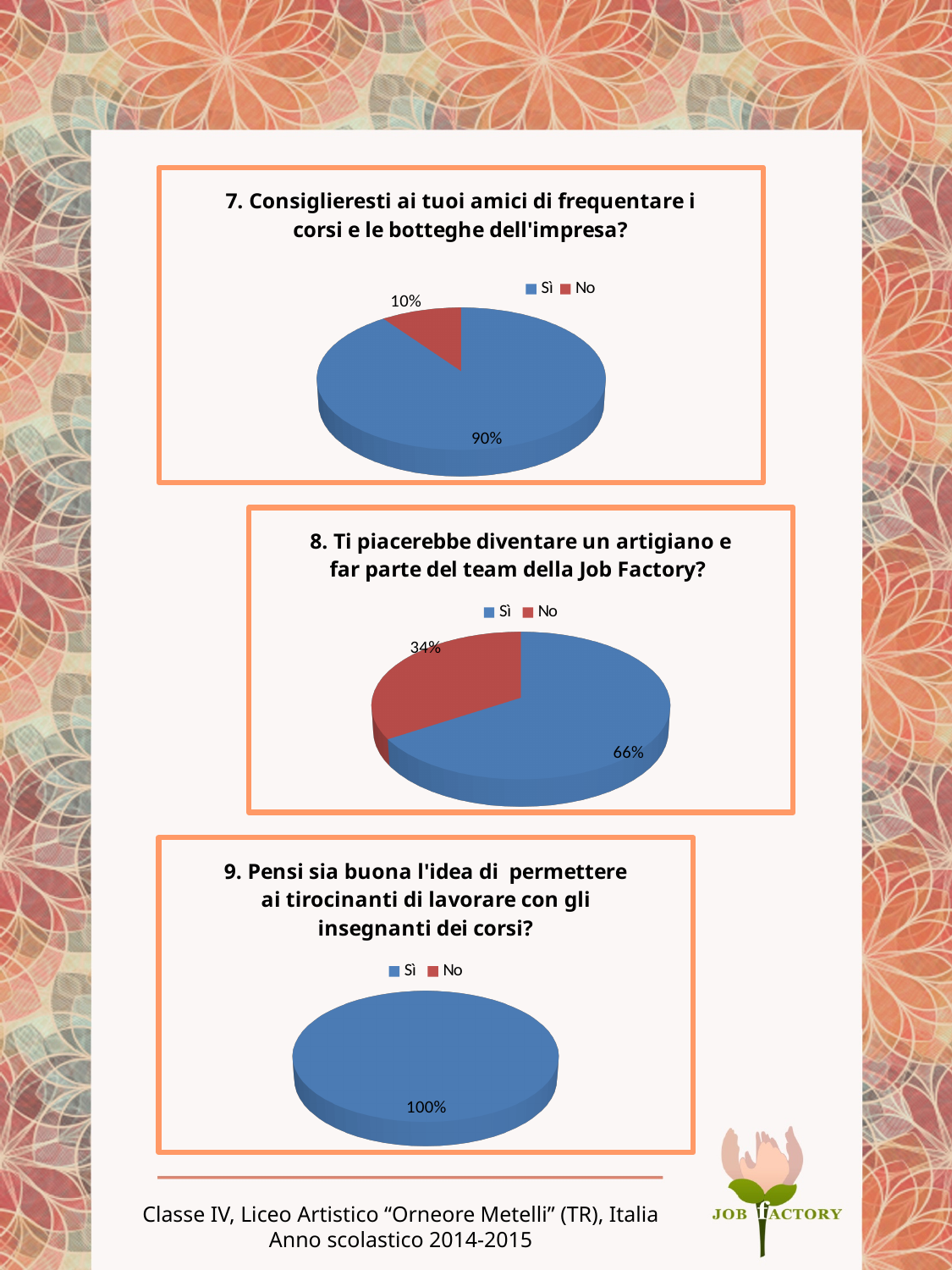
In the chart for question 7 (Consiglieresti ai tuoi amici...), what percentage answered No? 10% In the chart for question 8 (Ti piacerebbe diventare un artigiano...), what is the difference between the Sì and No percentages? 32% In the chart for question 8 (Ti piacerebbe diventare un artigiano...), what percentage answered No? 34% In the chart for question 8 (Ti piacerebbe diventare un artigiano...), what percentage answered Sì? 66% In the chart for question 9 (Pensi sia buona l'idea...), what percentage answered Sì? 100% How many entries does the legend list in the chart for question 9 (Pensi sia buona l'idea...)? 2 How many pie charts are shown on the slide? 3 In the chart for question 8 (Ti piacerebbe diventare un artigiano...), which answer has the smallest share? No In the chart for question 8 (Ti piacerebbe diventare un artigiano...), what colour represents the No answer? Red In the chart for question 7 (Consiglieresti ai tuoi amici...), what percentage answered Sì? 90% In the chart for question 7 (Consiglieresti ai tuoi amici...), which answer has the larger share, Sì or No? Sì What type of chart is used for question 7 (Consiglieresti ai tuoi amici...)? Pie chart